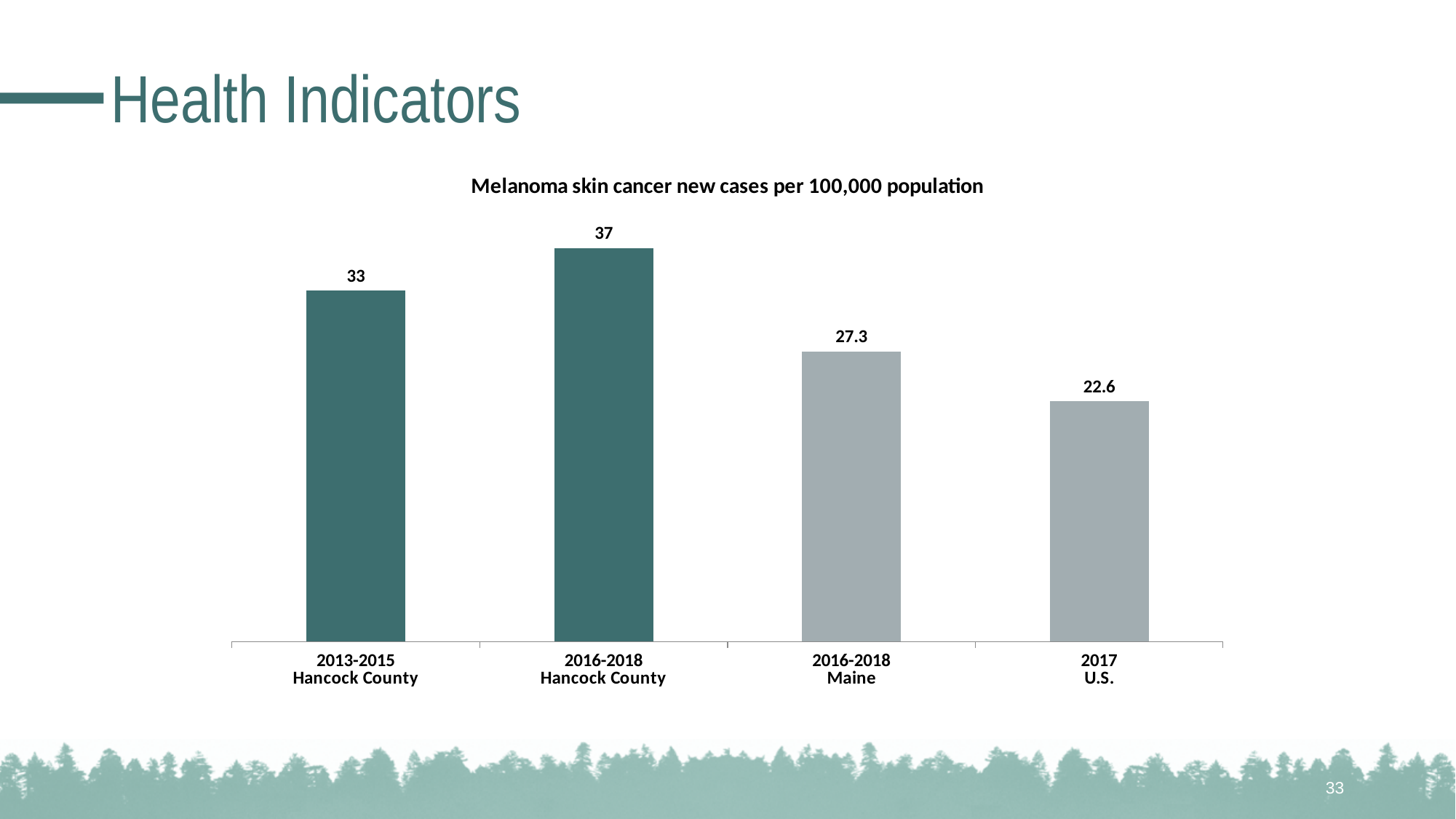
What is the title of the chart? Melanoma skin cancer new cases per 100,000 population Which is larger, the value for 2016-2018 Maine or the value for 2013-2015 Hancock County? 2013-2015 Hancock County What is the value for 2017 U.S.? 22.6 What is the value for 2013-2015 Hancock County? 33 Which category has the highest value? 2016-2018 Hancock County What is the difference between the 2016-2018 Maine value and the 2017 U.S. value? 4.7 What is the difference between the 2016-2018 Hancock County value and the 2013-2015 Hancock County value? 4 What is the value for 2016-2018 Maine? 27.3 Which category has the lowest value? 2017 U.S. How many bars are shown in the chart? 4 What is the value for 2016-2018 Hancock County? 37 What kind of chart is shown on the slide? Bar chart